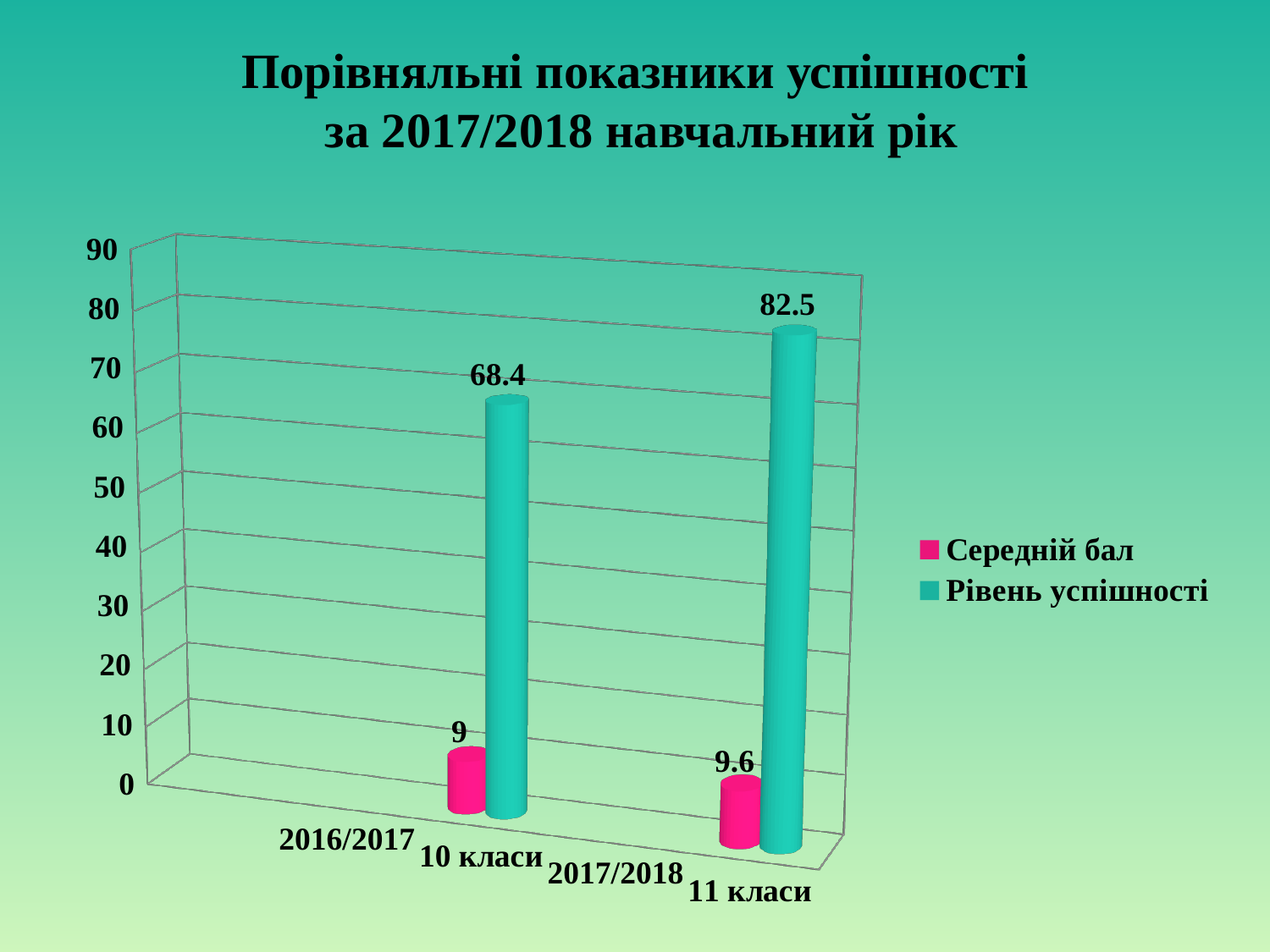
What is the difference in Рівень успішності between 2017/2018 11 класи and 2016/2017 10 класи? 14.1 Which series is shown in pink in the legend? Середній бал What is the difference in Середній бал between 2017/2018 11 класи and 2016/2017 10 класи? 0.6 Which category has the higher Рівень успішності? 2017/2018 11 класи What is the value of Середній бал for 2016/2017 10 класи? 9 What is the value of Середній бал for 2017/2018 11 класи? 9.6 Is the Рівень успішності for 2016/2017 10 класи greater or less than 70? less How many series does the legend list? 2 What is the value of Рівень успішності for 2016/2017 10 класи? 68.4 What kind of chart is shown on the slide? bar chart What is the value of Рівень успішності for 2017/2018 11 класи? 82.5 Which category has the lower Середній бал? 2016/2017 10 класи